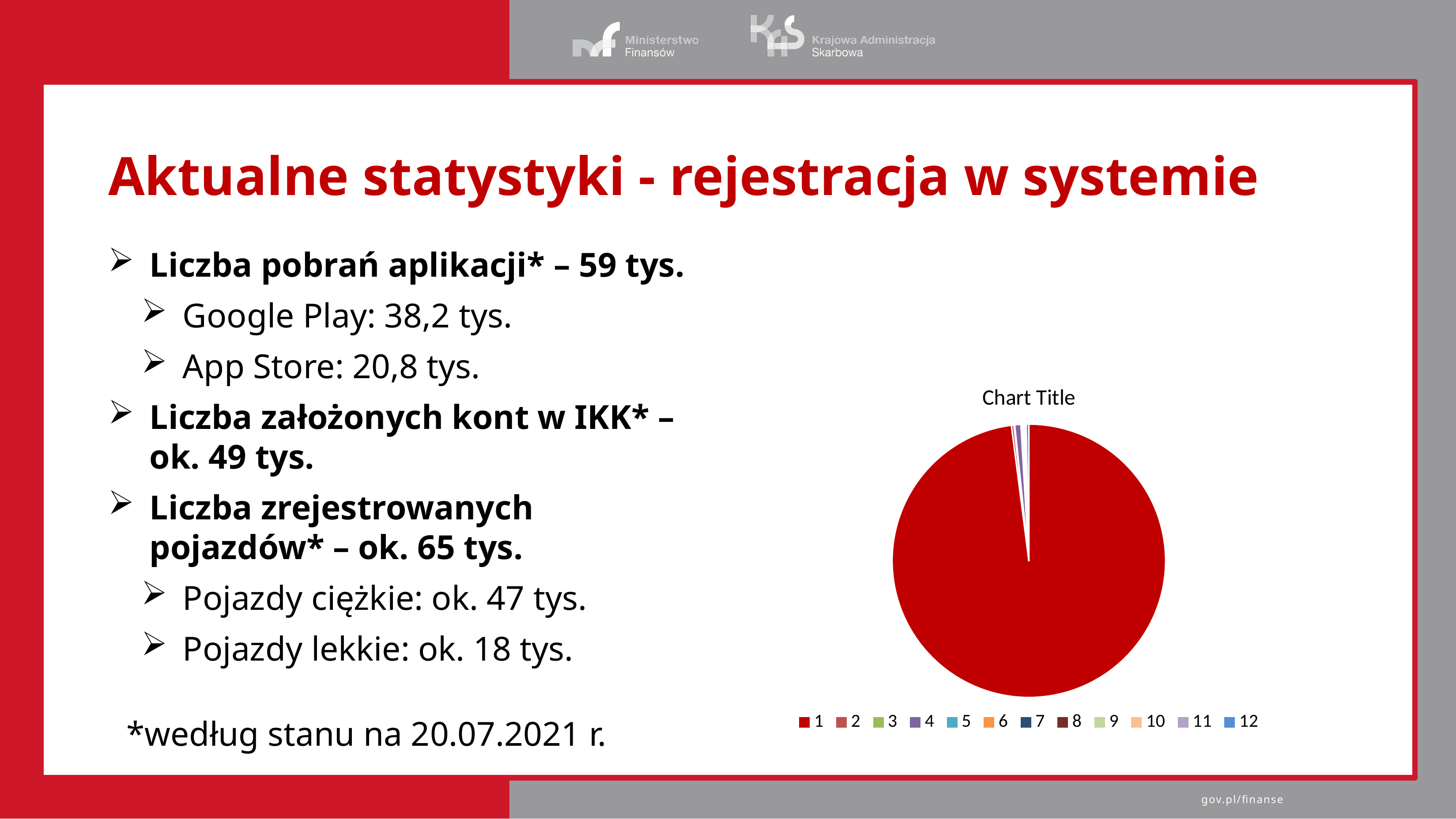
Which is larger in the pie chart, the slice for category 12 or the slice for category 1? 1 What is the title of the chart on the slide? Chart Title Which category has the largest slice of the pie? 1 What kind of chart is shown on the slide? pie chart Does the slice for category 1 take up more or less than half of the pie? more Which is larger in the pie chart, the slice for category 1 or the slice for category 2? 1 How many categories does the chart's legend list? 12 What colour is the slice for category 1 in the pie chart? red